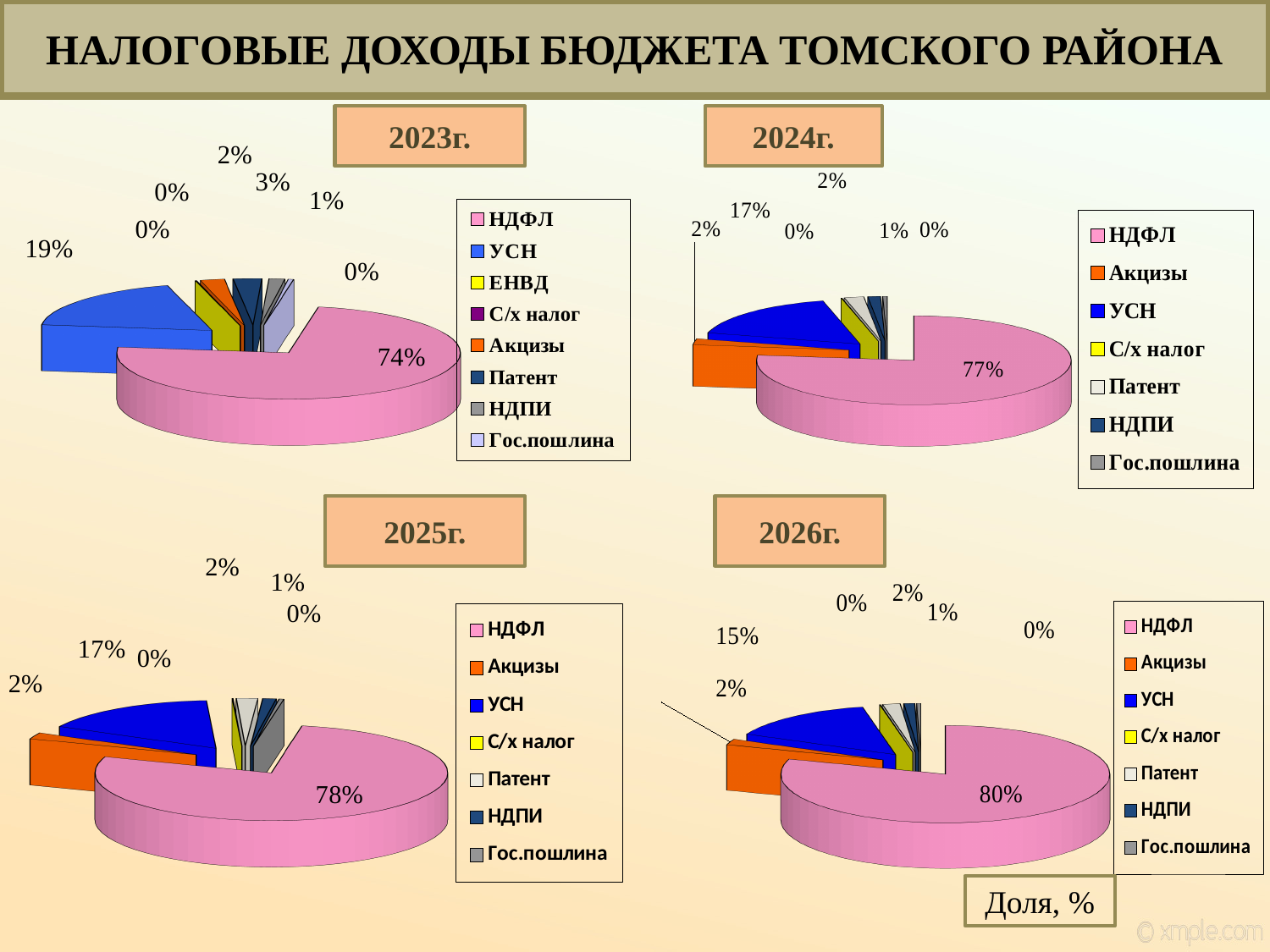
Across the four charts from 2023г. to 2026г., does the share of НДФЛ rise or fall? Rise In the 2023г. chart, what share does НДФЛ have? 74% In the 2025г. chart, which category has the largest share? НДФЛ What kind of chart is used for the 2026г. data? Pie chart In the 2024г. chart, what share does НДФЛ have? 77% In the 2026г. chart, what share does УСН have? 15% In the 2025г. chart, what share does НДФЛ have? 78% How many entries does the legend of the 2023г. chart list? 8 In the 2023г. chart, how many percentage points larger is the НДФЛ share than the УСН share? 55 In the 2026г. chart, what share does НДФЛ have? 80% In the 2024г. chart, which is larger, the share of НДФЛ or the share of УСН? НДФЛ In the 2023г. chart, what share does УСН have? 19%